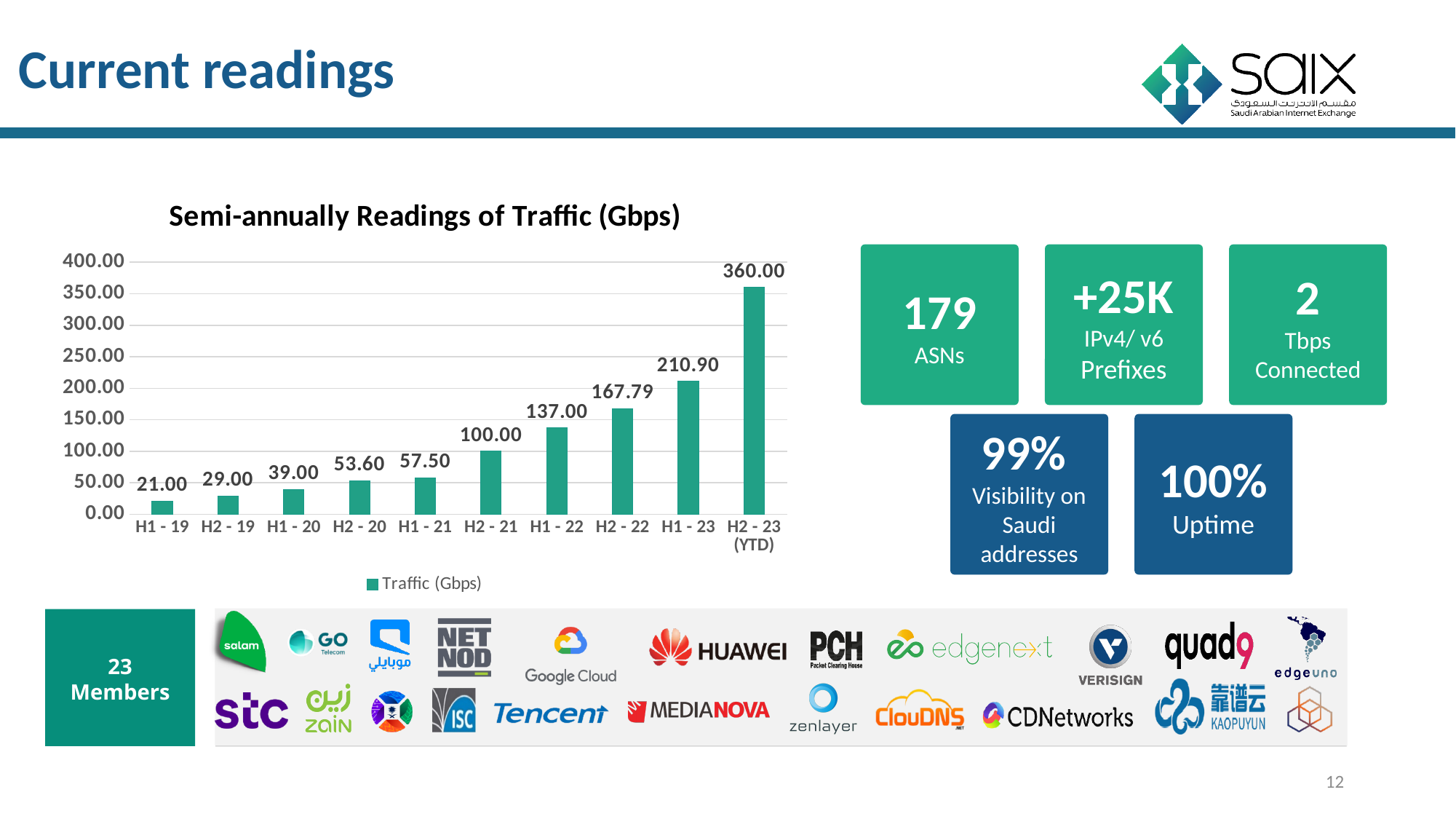
Is the traffic value for H2 - 21 greater or less than 150.00? less Which period has the lowest traffic reading? H1 - 19 How many series does the chart legend list? 1 How many periods are shown on the x axis of the chart? 10 What is the traffic value for H2 - 20? 53.60 What is the difference in traffic between H1 - 23 and H2 - 22? 43.11 Do the traffic values rise or fall from H1 - 19 to H2 - 23 (YTD)? rise Which period has the highest traffic reading? H2 - 23 (YTD) What is the traffic value for H2 - 23 (YTD)? 360.00 What kind of chart is shown on the slide? bar chart Which is larger, the traffic for H1 - 21 or H2 - 20? H1 - 21 What is the traffic value for H1 - 22? 137.00